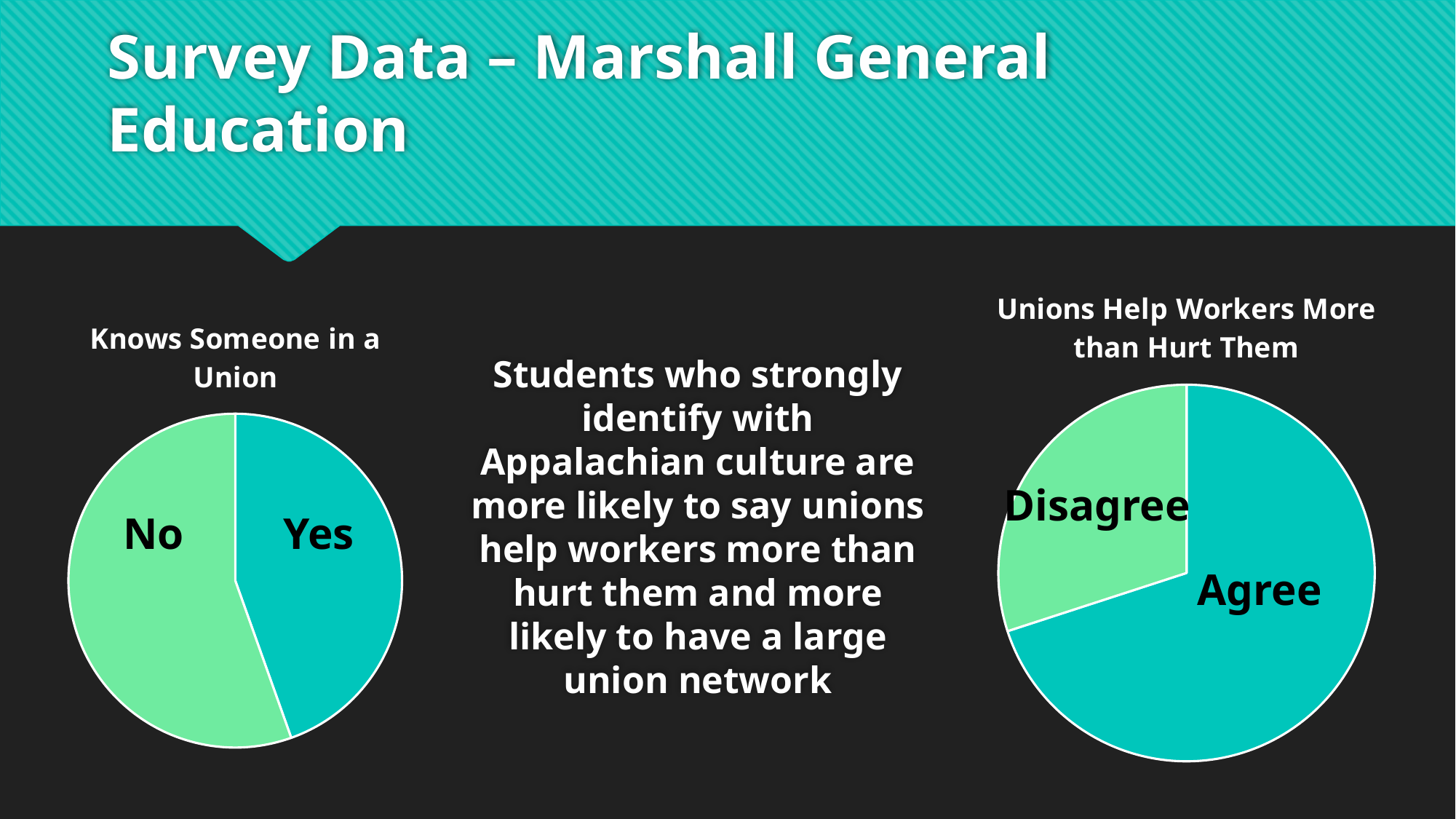
In the "Knows Someone in a Union" chart, which is larger, No or Yes? No What kind of chart is the "Unions Help Workers More than Hurt Them" chart? pie chart What are the two slice labels in the "Knows Someone in a Union" pie chart? No and Yes What kind of chart is the "Knows Someone in a Union" chart? pie chart How many slices does the "Unions Help Workers More than Hurt Them" pie chart have? 2 In the "Unions Help Workers More than Hurt Them" chart, which is larger, Agree or Disagree? Agree In the "Unions Help Workers More than Hurt Them" chart, which slice is the smallest? Disagree In the "Unions Help Workers More than Hurt Them" chart, which slice is the largest? Agree How many slices does the "Knows Someone in a Union" pie chart have? 2 What is the title of the pie chart on the right side of the slide? Unions Help Workers More than Hurt Them